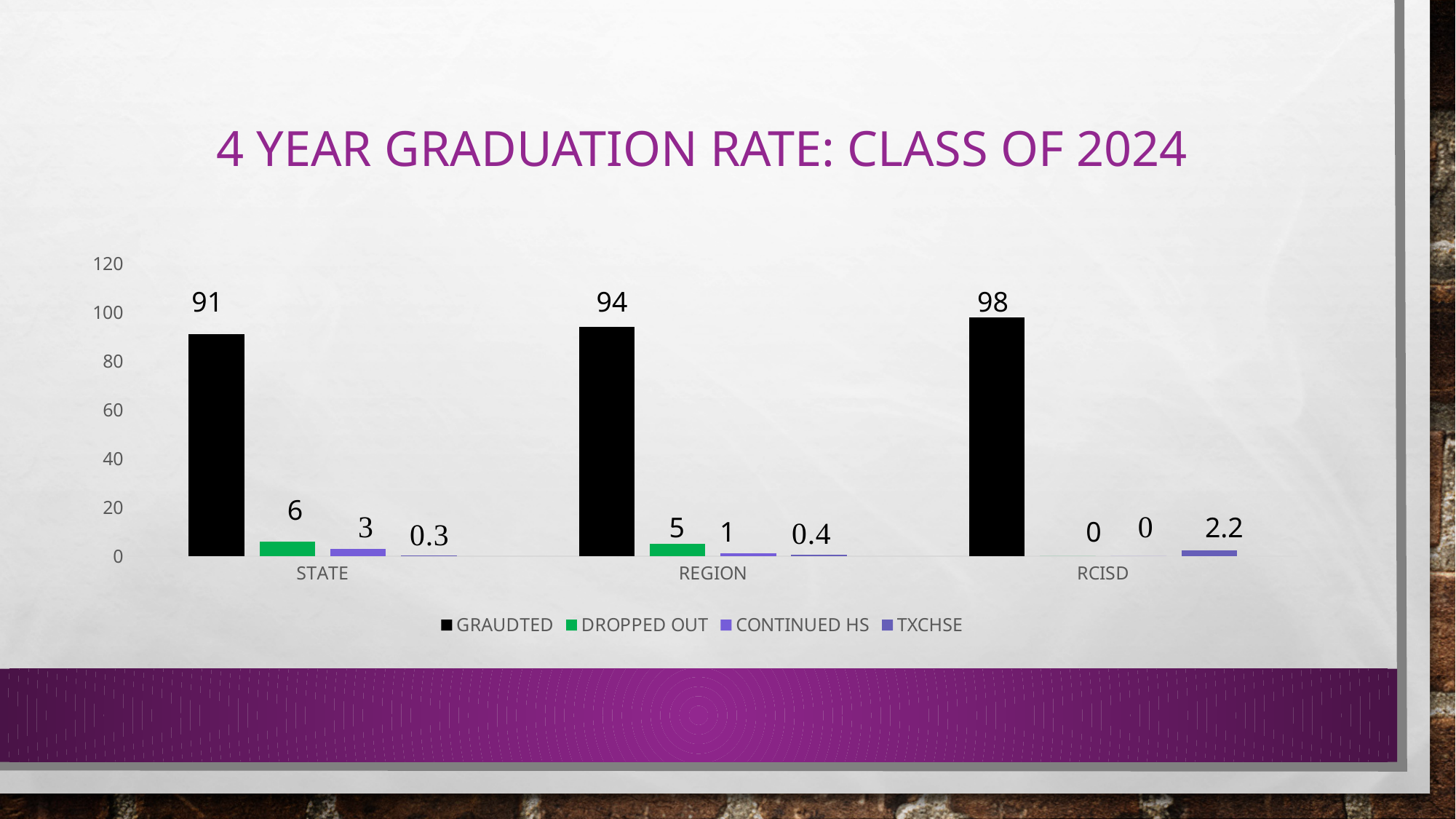
What is the difference between the GRAUDTED values for RCISD and STATE? 7 What kind of chart is shown on the slide? bar chart Which category has the lowest DROPPED OUT value? RCISD How many categories are shown on the x axis? 3 What is the DROPPED OUT value for STATE? 6 How many series does the legend list? 4 What is the GRAUDTED value for RCISD? 98 Which category has the highest GRAUDTED value? RCISD Which is larger, the DROPPED OUT value for STATE or for REGION? STATE What is the TXCHSE value for REGION? 0.4 What is the CONTINUED HS value for RCISD? 0 What is the title of the slide? 4 YEAR GRADUATION RATE: CLASS OF 2024